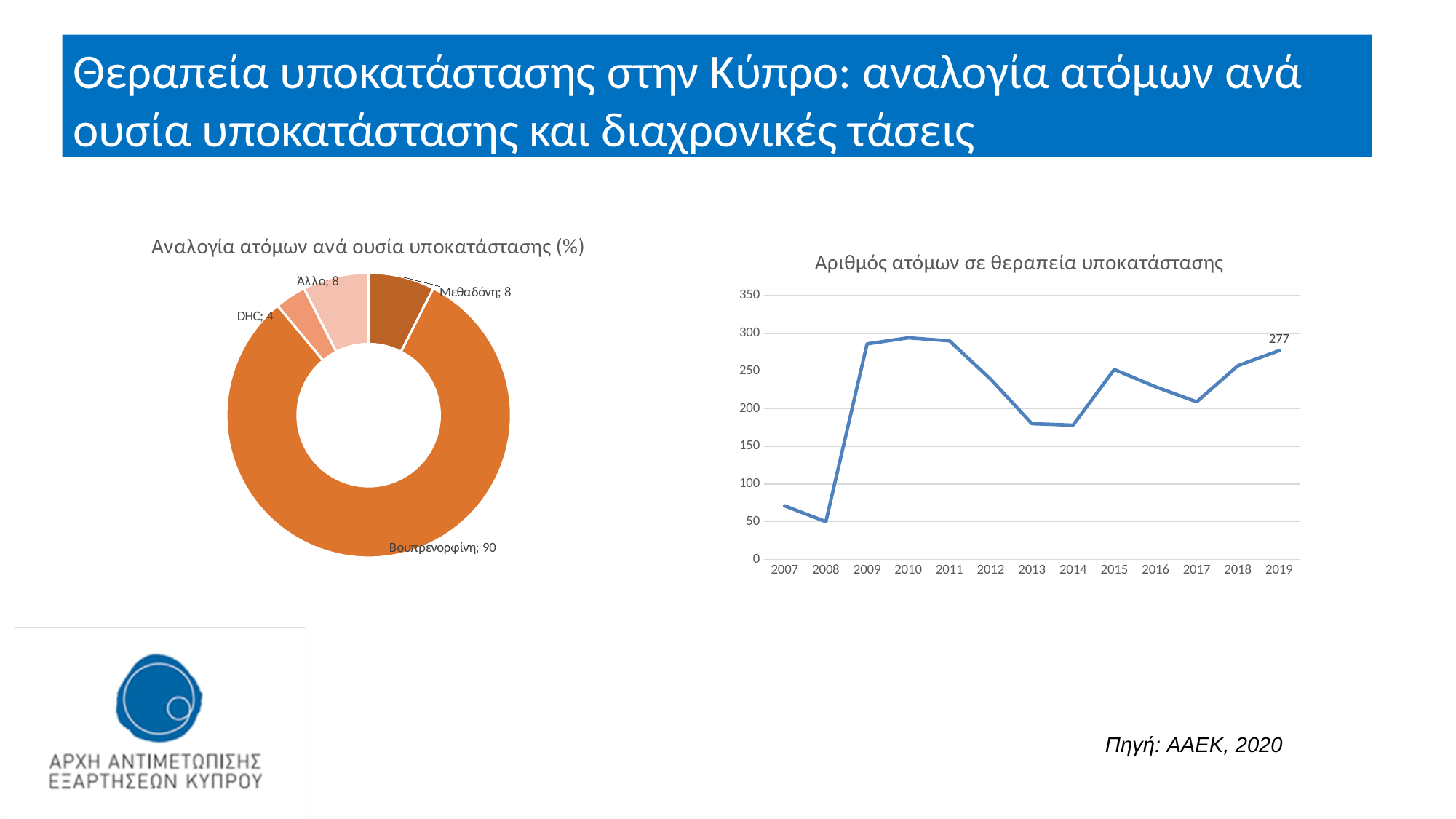
In the chart titled "Αναλογία ατόμων ανά ουσία υποκατάστασης (%)", what is the value for DHC? 4 In the chart titled "Αναλογία ατόμων ανά ουσία υποκατάστασης (%)", how many categories are shown? 4 In the chart titled "Αναλογία ατόμων ανά ουσία υποκατάστασης (%)", what is the difference between the values for Βουπρενορφίνη and Μεθαδόνη? 82 In the chart titled "Αναλογία ατόμων ανά ουσία υποκατάστασης (%)", which category has the smallest share? DHC In the chart titled "Αριθμός ατόμων σε θεραπεία υποκατάστασης", is the value for 2008 greater or less than 100? less In the chart titled "Αναλογία ατόμων ανά ουσία υποκατάστασης (%)", which category has the largest share? Βουπρενορφίνη In the chart titled "Αριθμός ατόμων σε θεραπεία υποκατάστασης", is the value for 2010 greater or less than 250? greater What kind of chart is the one titled "Αριθμός ατόμων σε θεραπεία υποκατάστασης"? Line chart In the chart titled "Αριθμός ατόμων σε θεραπεία υποκατάστασης", what is the value for 2019? 277 In the chart titled "Αναλογία ατόμων ανά ουσία υποκατάστασης (%)", what is the value for Βουπρενορφίνη? 90 In the chart titled "Αριθμός ατόμων σε θεραπεία υποκατάστασης", which year has the lowest value? 2008 What kind of chart is the one titled "Αναλογία ατόμων ανά ουσία υποκατάστασης (%)"? Doughnut (pie) chart